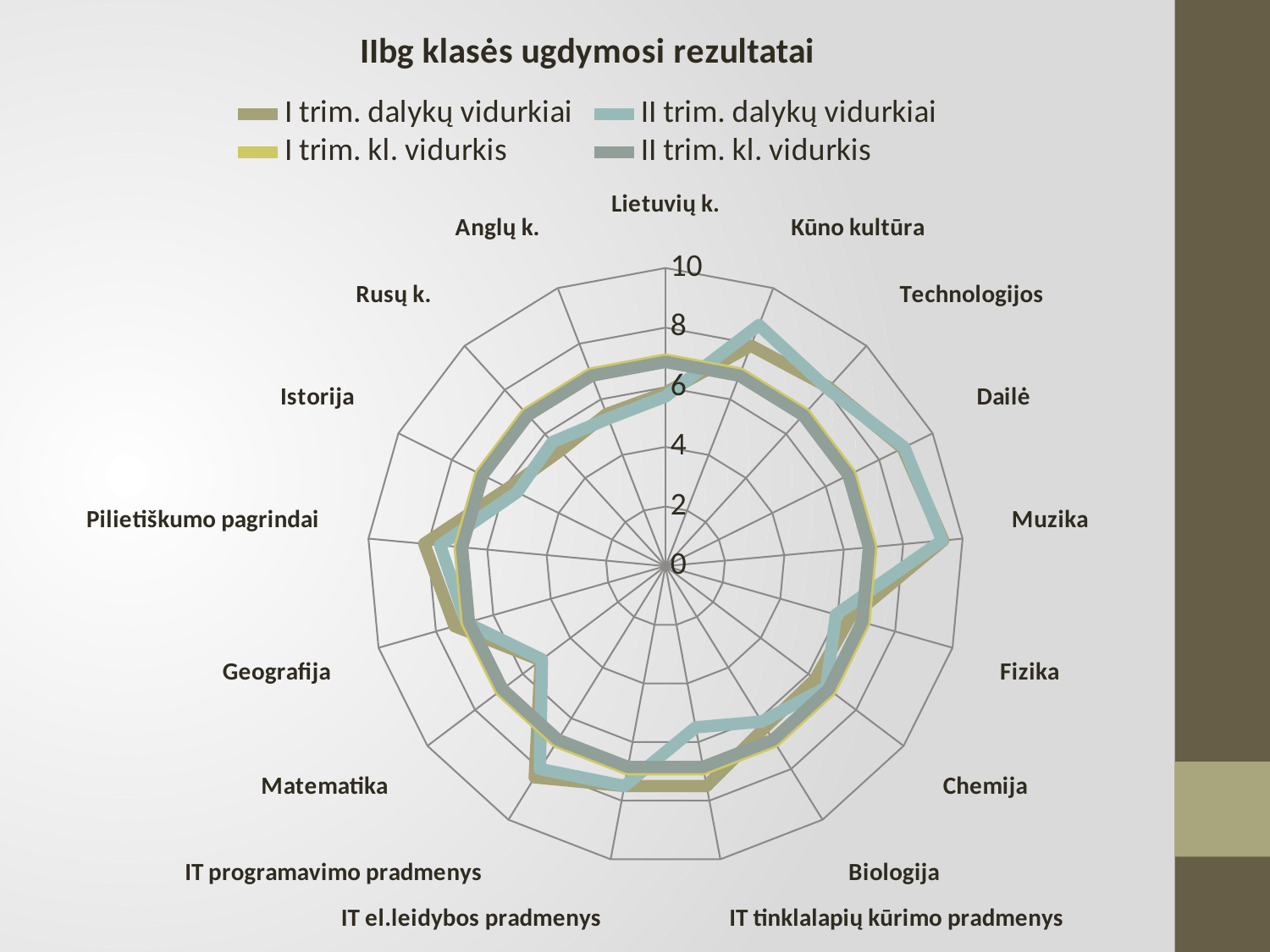
Is the value of II trim. dalykų vidurkiai for Muzika greater or less than 8? greater What is the title of the chart? IIbg klasės ugdymosi rezultatai How many series does the legend list? 4 Is the value of I trim. dalykų vidurkiai for Pilietiškumo pagrindai greater or less than 6? greater How many subject categories are plotted around the radar chart? 17 What type of chart is shown on the slide? Radar chart Is the value of II trim. dalykų vidurkiai for Kūno kultūra greater or less than 6? greater Which series is drawn in light blue according to the legend? II trim. dalykų vidurkiai For which subject does the II trim. dalykų vidurkiai series reach its highest value? Muzika